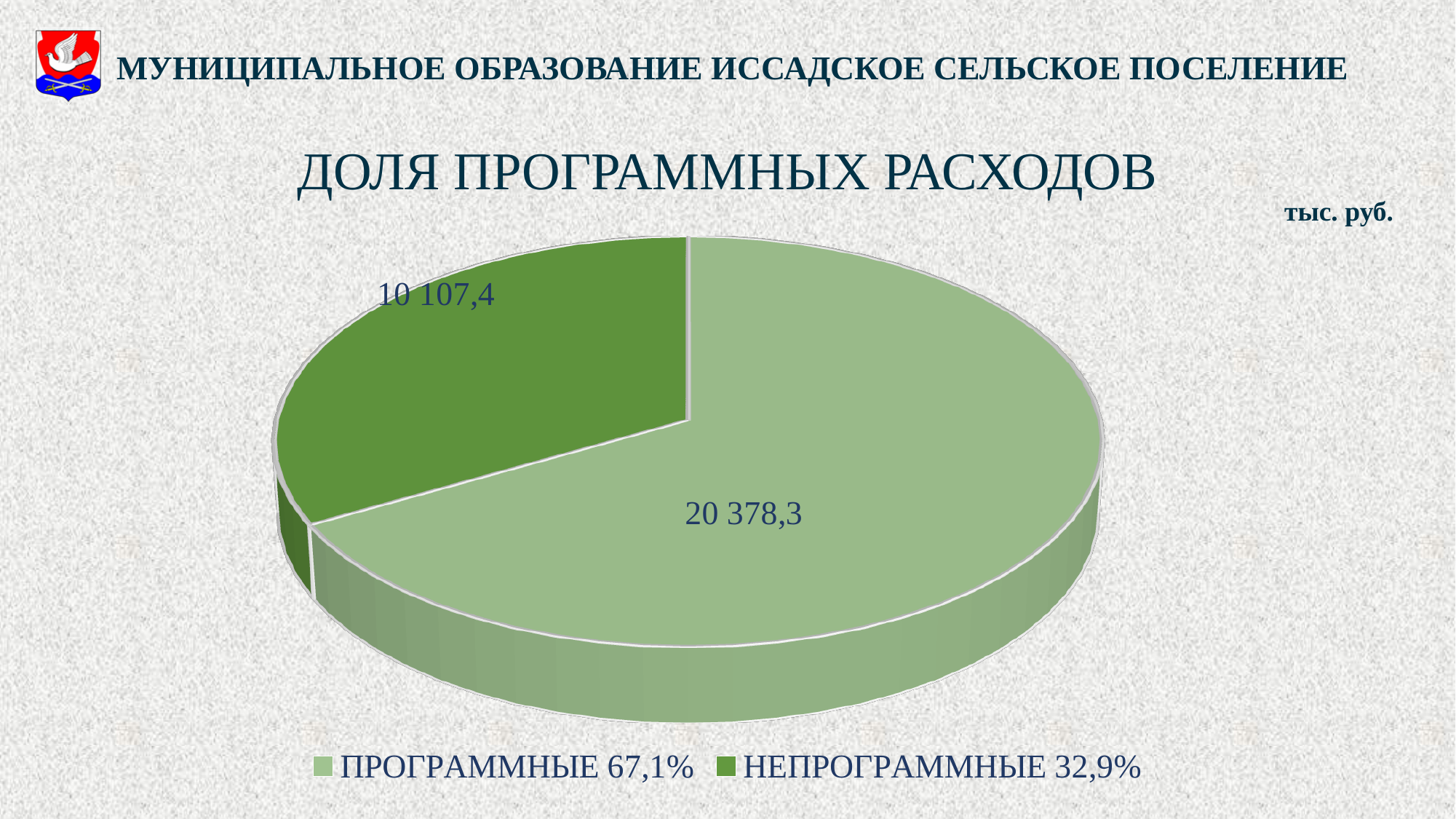
What share of the pie does НЕПРОГРАММНЫЕ represent? 32,9% What is the difference between the values for ПРОГРАММНЫЕ and НЕПРОГРАММНЫЕ? 10 270,9 What type of chart is shown on the slide? pie chart Which is larger, ПРОГРАММНЫЕ or НЕПРОГРАММНЫЕ? ПРОГРАММНЫЕ What share of the pie does ПРОГРАММНЫЕ represent? 67,1% How many slices does the pie chart have? 2 Which slice is the largest? ПРОГРАММНЫЕ Which slice is the smallest? НЕПРОГРАММНЫЕ What is the title of the chart? ДОЛЯ ПРОГРАММНЫХ РАСХОДОВ What is the value for ПРОГРАММНЫЕ? 20 378,3 What unit is indicated for the chart values? тыс. руб. What is the value for НЕПРОГРАММНЫЕ? 10 107,4